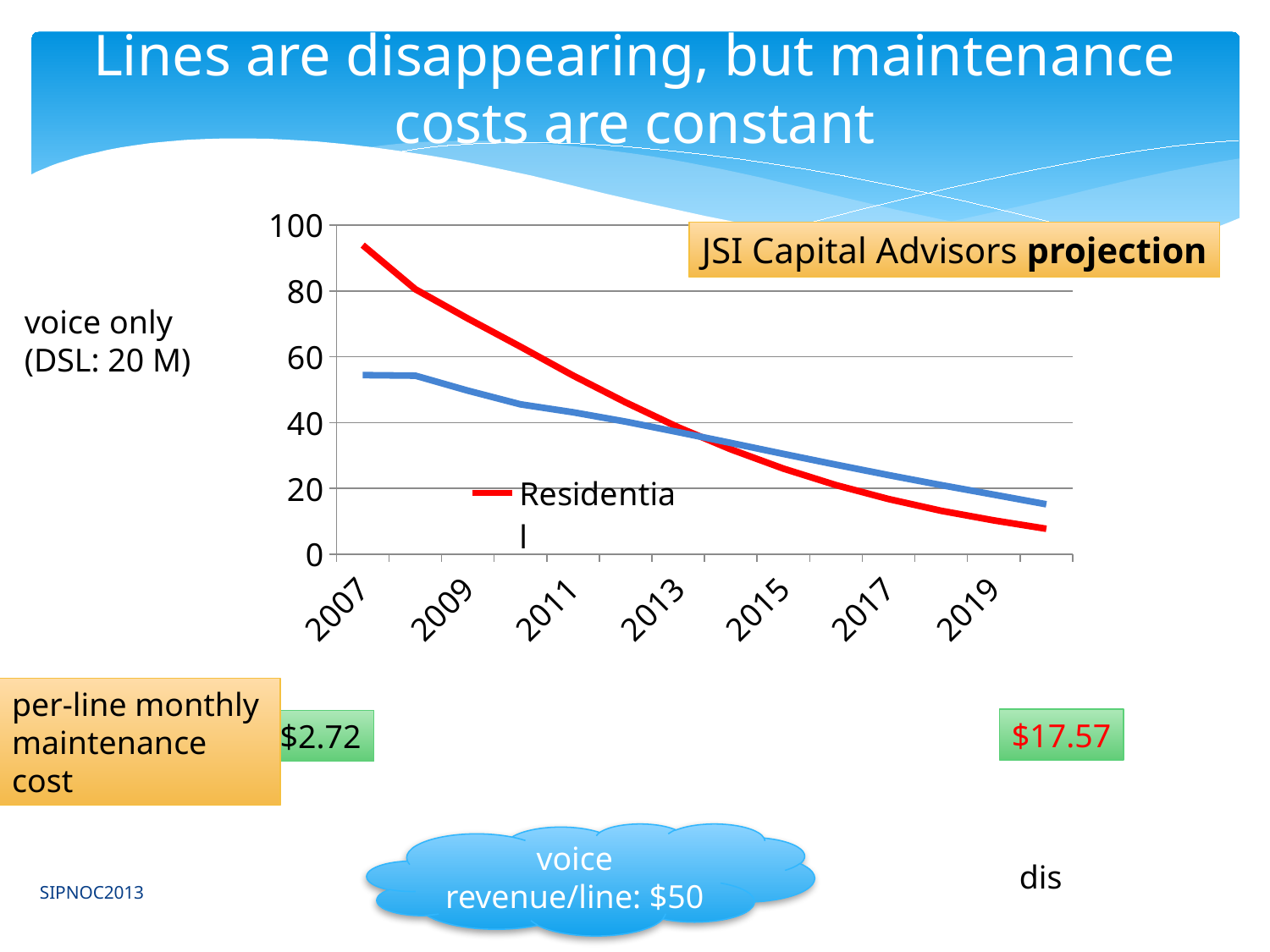
Is the Residential value in 2019 greater or less than 20? less What kind of chart is shown on the slide? line chart Is the Residential value in 2011 greater or less than 40? greater In 2007, which line is higher: the Residential line or the blue line? Residential Does the blue line rise or fall from 2007 to 2019? fall What series name is shown in the chart legend? Residential What colour is the Residential line? red Is the value of the blue line in 2019 greater or less than 40? less In 2019, which line is higher: the Residential line or the blue line? the blue line Does the Residential line rise or fall from 2007 to 2019? fall